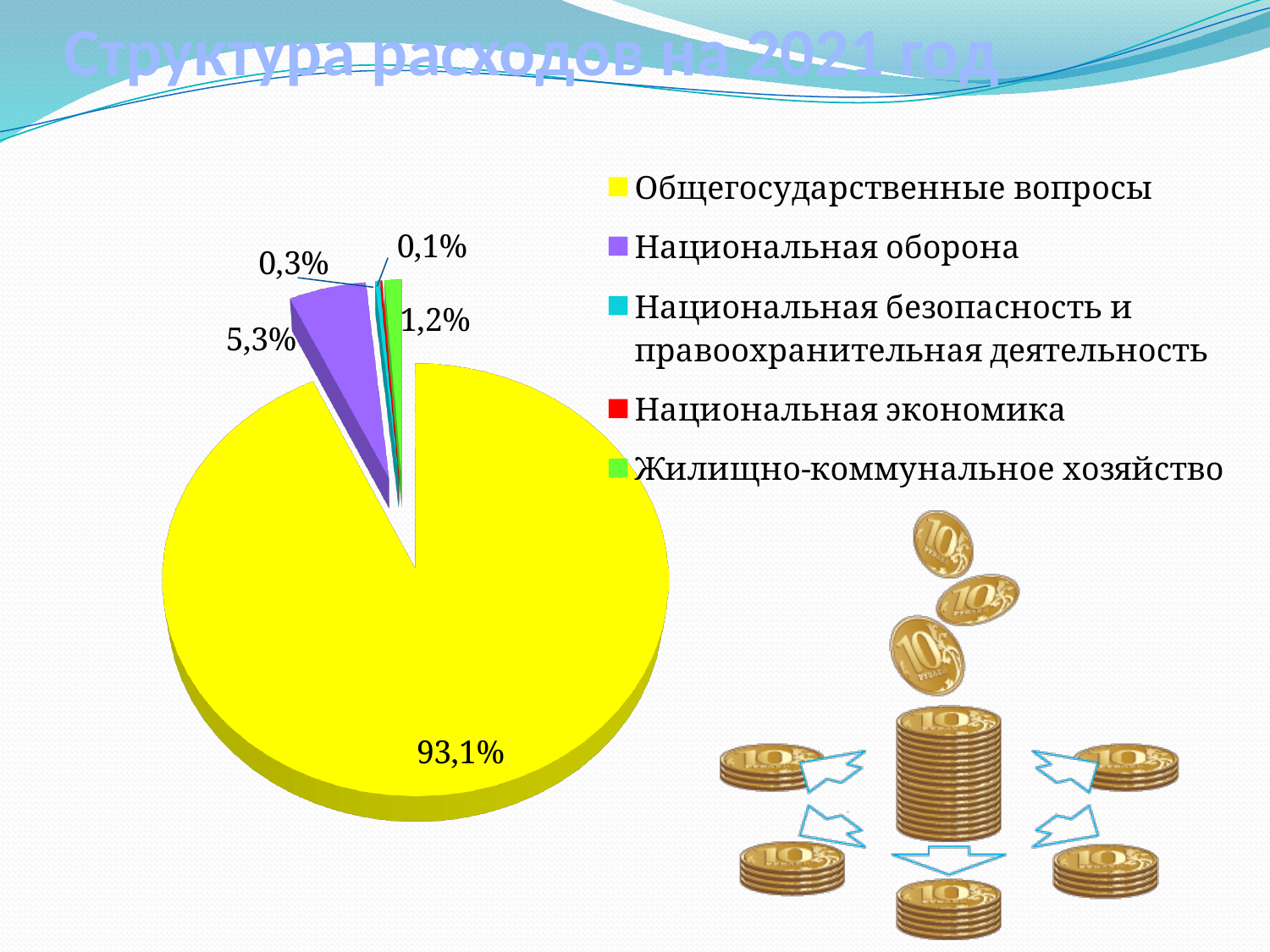
What is the share for Национальная безопасность и правоохранительная деятельность? 0,3% Which category has the smallest share of the pie? Национальная экономика Which category has the largest share of the pie? Общегосударственные вопросы What is the share for Общегосударственные вопросы? 93,1% What is the share for Национальная оборона? 5,3% What colour is the slice for Национальная оборона? purple What is the difference between the share for Национальная оборона and the share for Жилищно-коммунальное хозяйство? 4,1% How many categories does the legend list? 5 What is the share for Национальная экономика? 0,1% Which is larger, the share for Национальная оборона or the share for Жилищно-коммунальное хозяйство? Национальная оборона What kind of chart is shown on the slide? pie chart What is the share for Жилищно-коммунальное хозяйство? 1,2%